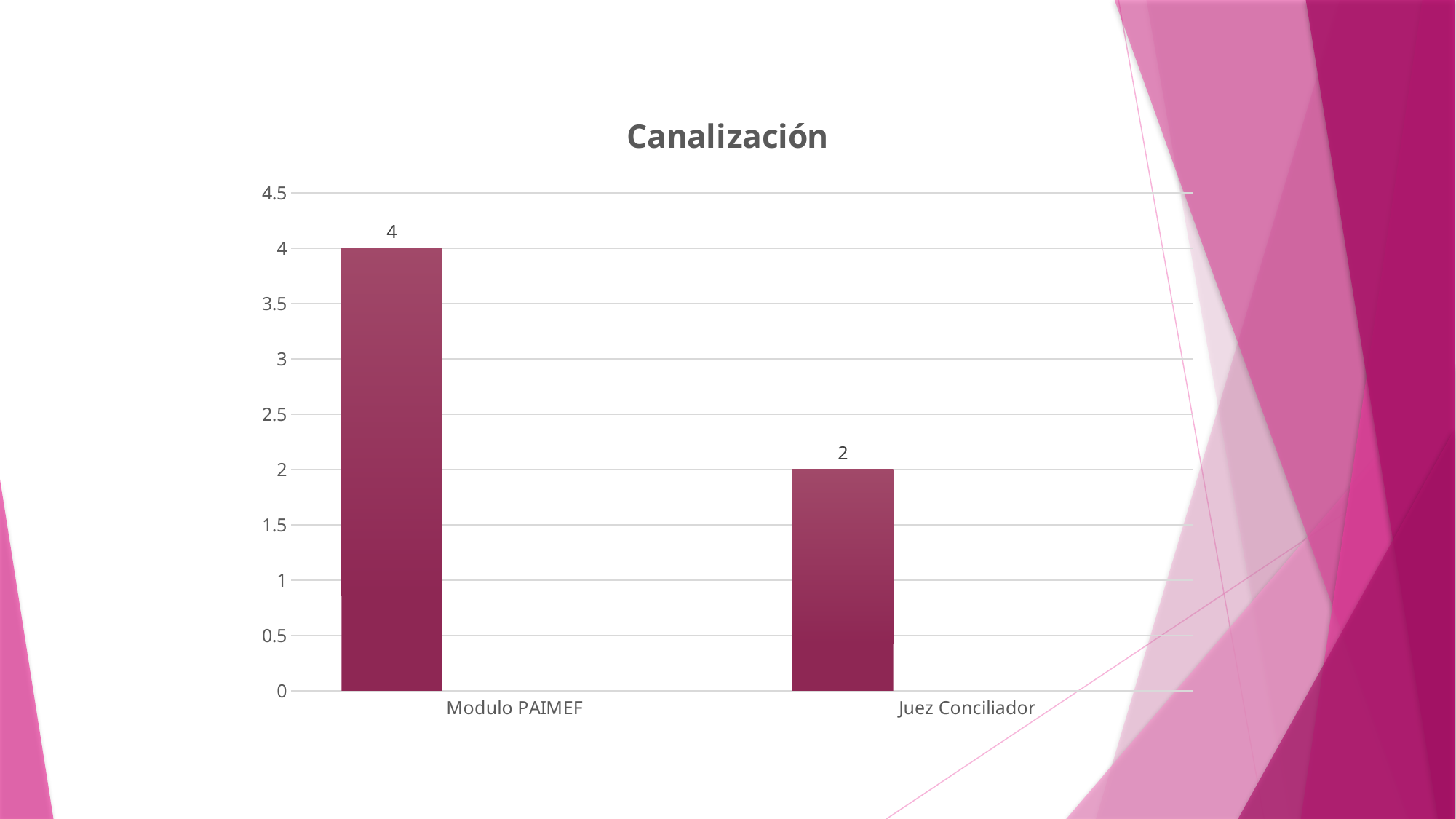
What is the difference between the values for Modulo PAIMEF and Juez Conciliador? 2 Is the value for Modulo PAIMEF greater or less than 3? greater Is the value for Juez Conciliador greater or less than 3? less What is the value for Juez Conciliador? 2 Which category has the lowest value? Juez Conciliador Which is larger, the value for Modulo PAIMEF or the value for Juez Conciliador? Modulo PAIMEF What kind of chart is shown on the slide? bar chart What is the title of the chart? Canalización Which category has the highest value? Modulo PAIMEF How many categories are shown on the chart? 2 What is the highest value shown on the vertical axis? 4.5 What is the value for Modulo PAIMEF? 4